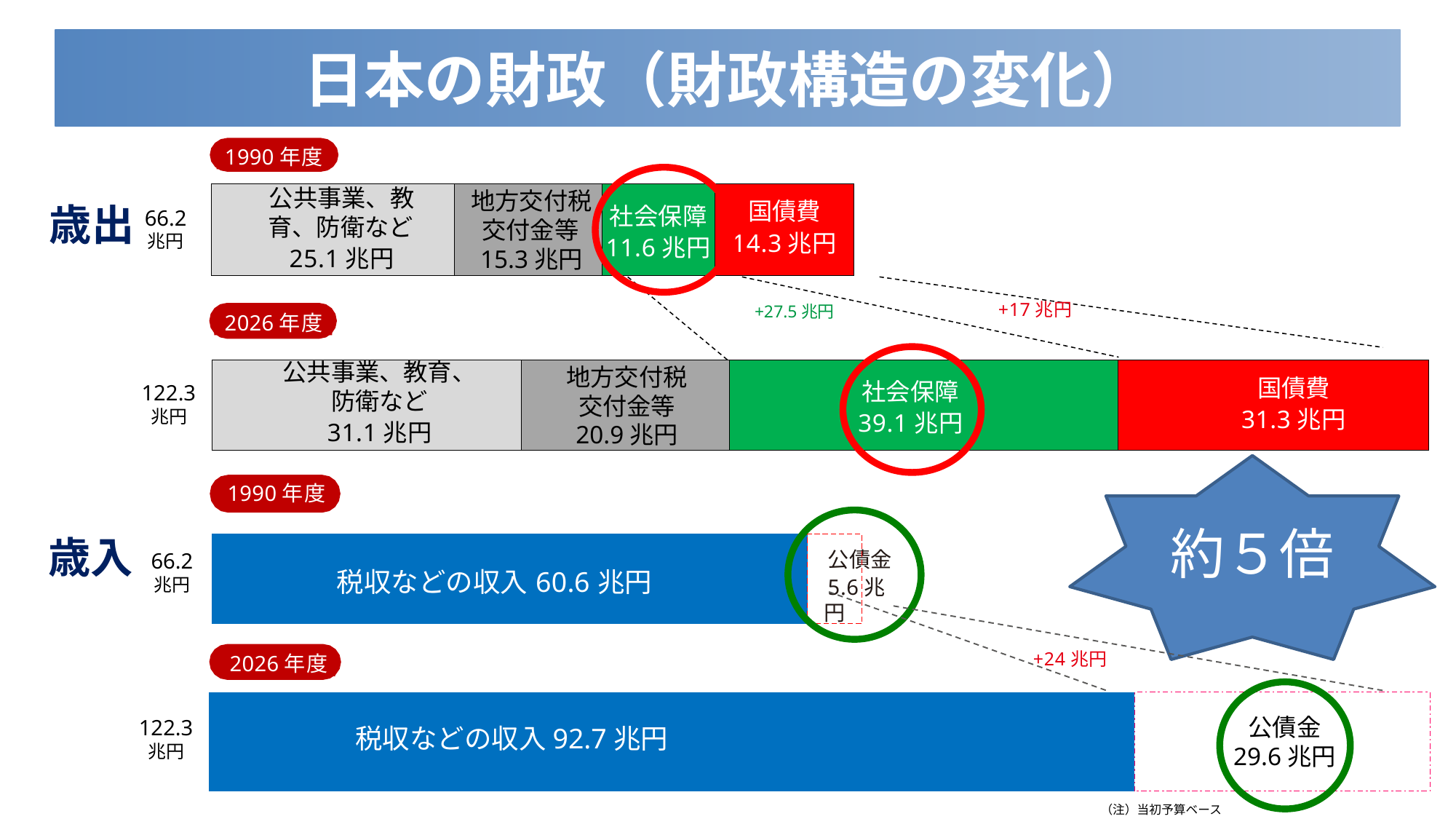
歳出の2026年度のバーで、国債費の値はいくらですか？ 31.3 兆円 歳出の1990年度のバーで、最も小さい項目はどれですか？ 社会保障 歳入の公債金は、1990年度から2026年度で何兆円増えましたか？ 24 兆円 歳出の2026年度のバーで、最も大きい項目はどれですか？ 社会保障 このスライドのグラフはどの種類のグラフですか？ 積み上げ棒グラフ 歳入の2026年度のバーで、公債金の値はいくらですか？ 29.6 兆円 歳出の1990年度のバーは、いくつの項目で構成されていますか？ 4 歳出の2026年度のバーで、公共事業、教育、防衛などと国債費ではどちらが大きいですか？ 国債費 歳入の1990年度のバーの合計はいくらですか？ 66.2 兆円 歳出の1990年度のバーで、社会保障の値はいくらですか？ 11.6 兆円 歳出の社会保障は、1990年度から2026年度で何兆円増えましたか？ 27.5 兆円 歳出の2026年度のバーの合計はいくらですか？ 122.3 兆円